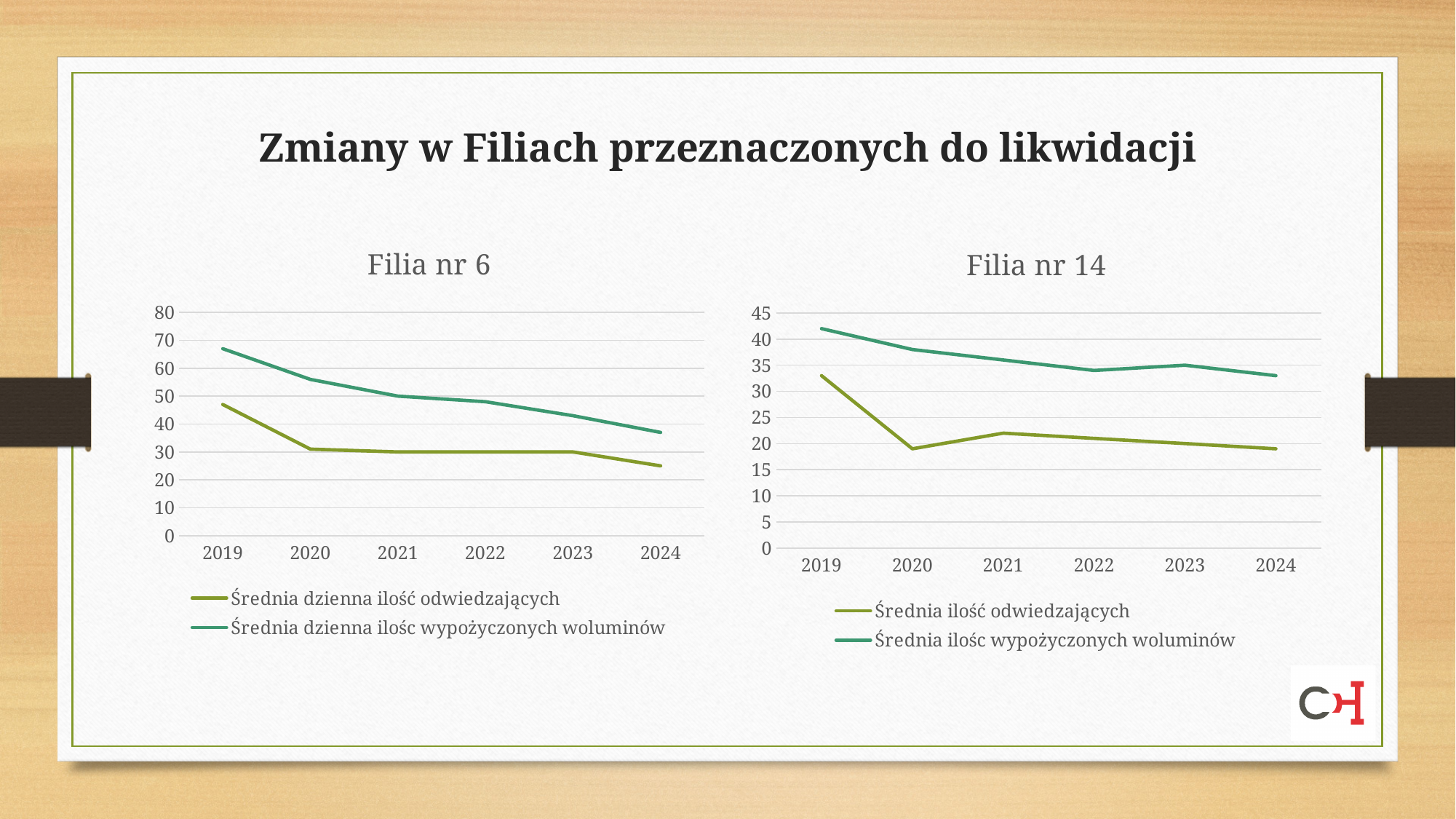
In the "Filia nr 6" chart, in which year is Średnia dzienna ilość odwiedzających lowest? 2024 In the "Filia nr 14" chart, which series is higher in 2019: Średnia ilość odwiedzających or Średnia ilośc wypożyczonych woluminów? Średnia ilośc wypożyczonych woluminów In the "Filia nr 14" chart, is the value for Średnia ilośc wypożyczonych woluminów in 2024 greater or less than 30? greater In the "Filia nr 6" chart, is the value for Średnia dzienna ilość odwiedzających in 2024 greater or less than 30? less What kind of chart is the "Filia nr 6" chart? line chart How many years are shown on the x axis of the "Filia nr 6" chart? 6 In the "Filia nr 14" chart, does Średnia ilośc wypożyczonych woluminów generally rise or fall from 2019 to 2024? fall In the "Filia nr 14" chart, is the value for Średnia ilość odwiedzających in 2019 greater or less than 30? greater How many series does the legend of the "Filia nr 14" chart list? 2 In the "Filia nr 6" chart, in which year is Średnia dzienna ilośc wypożyczonych woluminów highest? 2019